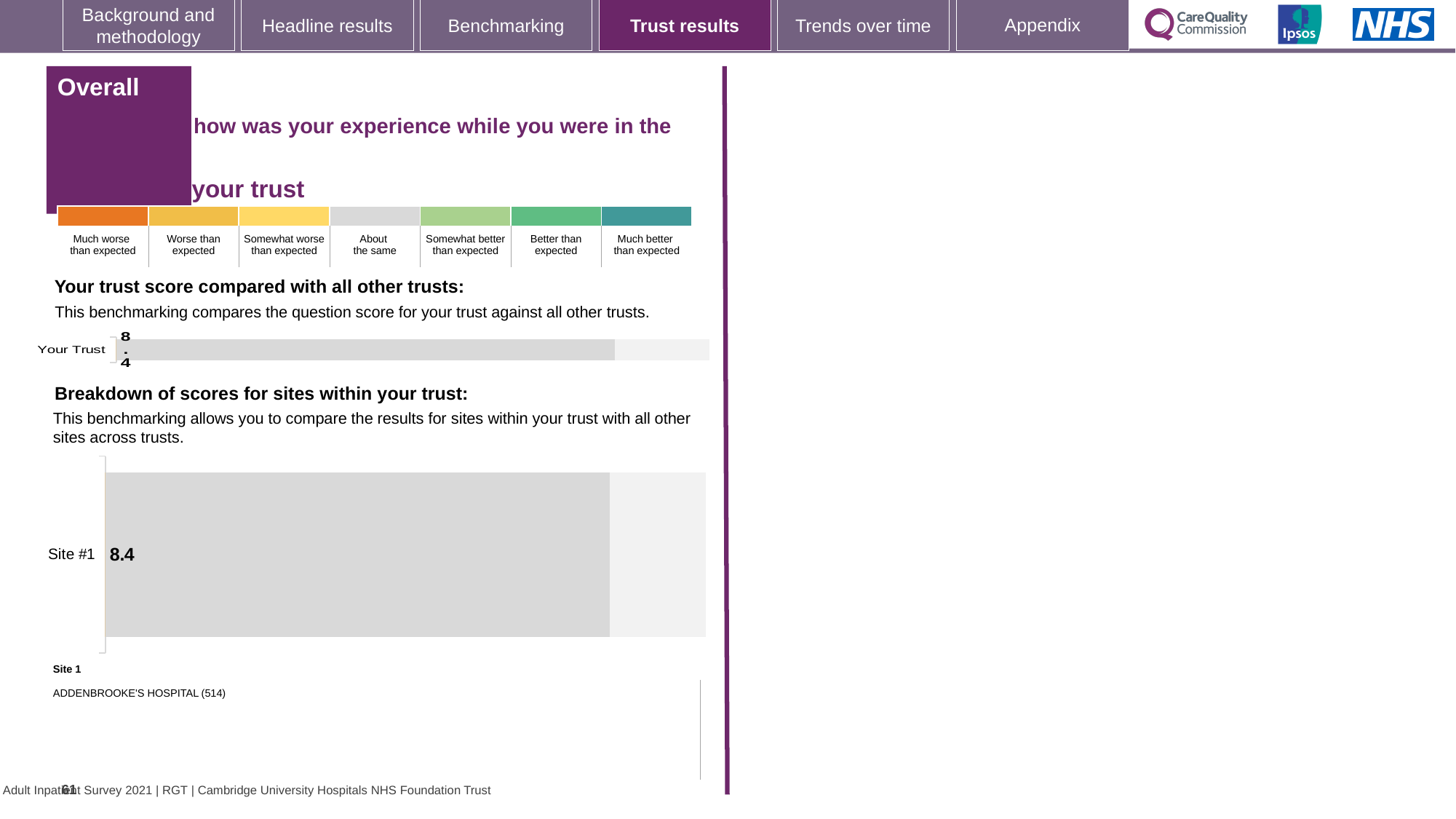
Is the Site #1 score higher, lower or the same as the Your Trust score? the same What kind of chart is the 'Breakdown of scores for sites within your trust' chart? bar chart What is the difference between the Your Trust score and the Site #1 score? 0.0 In the 'Your trust score compared with all other trusts' chart, what is the score for Your Trust? 8.4 How many bars are plotted in the 'Your trust score compared with all other trusts' chart? 1 What kind of chart is the 'Your trust score compared with all other trusts' chart? bar chart In the 'Breakdown of scores for sites within your trust' chart, what is the score for Site #1? 8.4 Which hospital is listed as Site 1 below the 'Breakdown of scores for sites within your trust' chart? ADDENBROOKE'S HOSPITAL (514) How many sites are plotted in the 'Breakdown of scores for sites within your trust' chart? 1 How many rating categories are shown in the colour key above the charts, from 'Much worse than expected' to 'Much better than expected'? 7